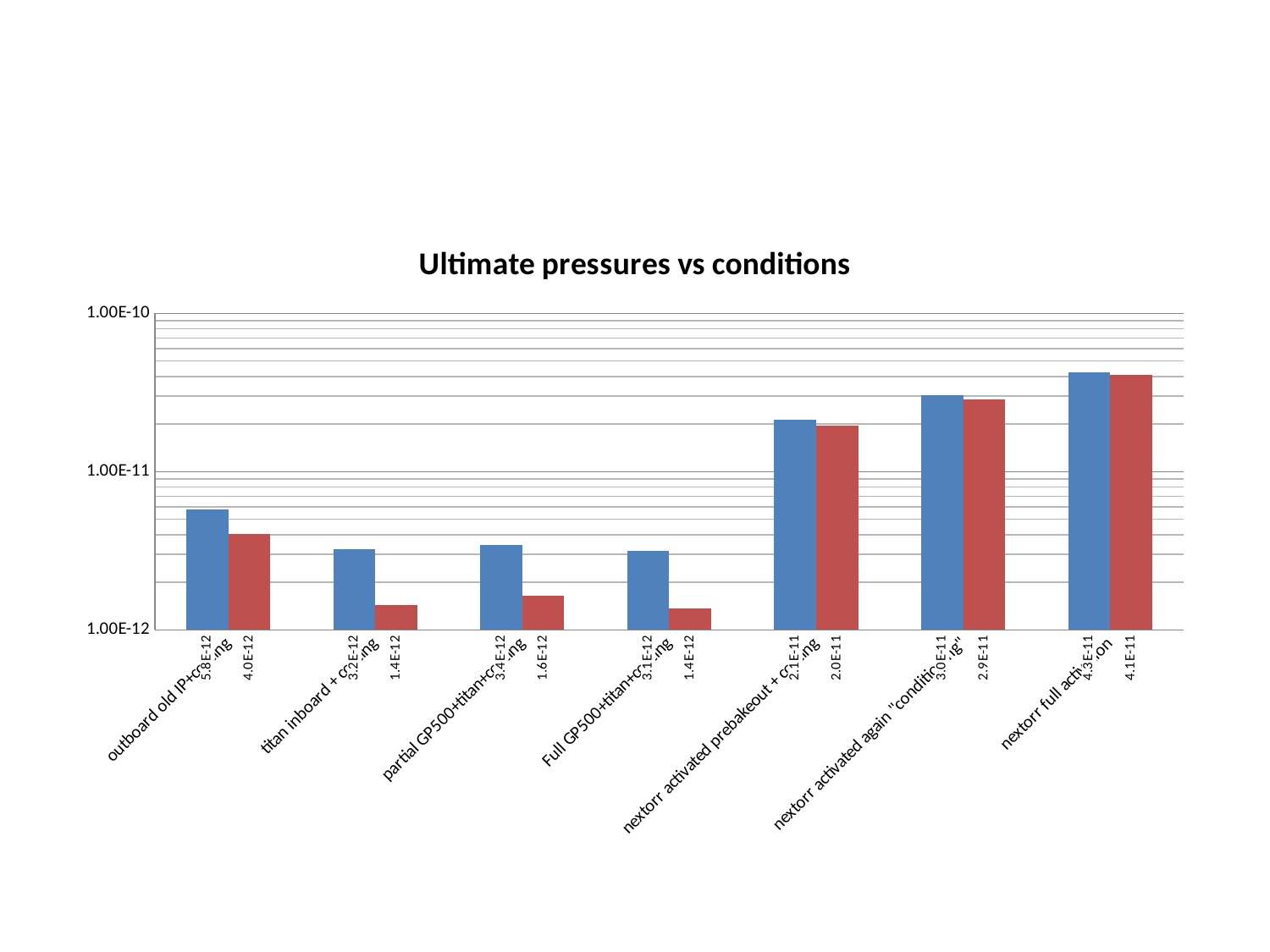
What is the value of the blue bar for the first category, 'outboard old IP'? 5.8E-12 What is the value of the red bar for the 'titan inboard' category? 1.4E-12 What is the value of the blue bar for the 'partial GP500+titan' category? 3.4E-12 Which is larger for the 'nextorr activated prebakeout' category, the blue bar or the red bar? the blue bar How many categories (conditions) are plotted along the x axis? 7 What is the value of the red bar for the first category, 'outboard old IP'? 4.0E-12 What type of chart is shown on the slide? bar chart Which category has the highest blue bar? nextorr full acti... (the last category) What is the title of the chart? Ultimate pressures vs conditions What is the value of the blue bar for the last category, 'nextorr full acti...'? 4.3E-11 Is the blue bar for the 'nextorr activated again' category greater or less than 1.00E-11? greater Which category has the lowest blue bar? Full GP500+titan (the fourth category)